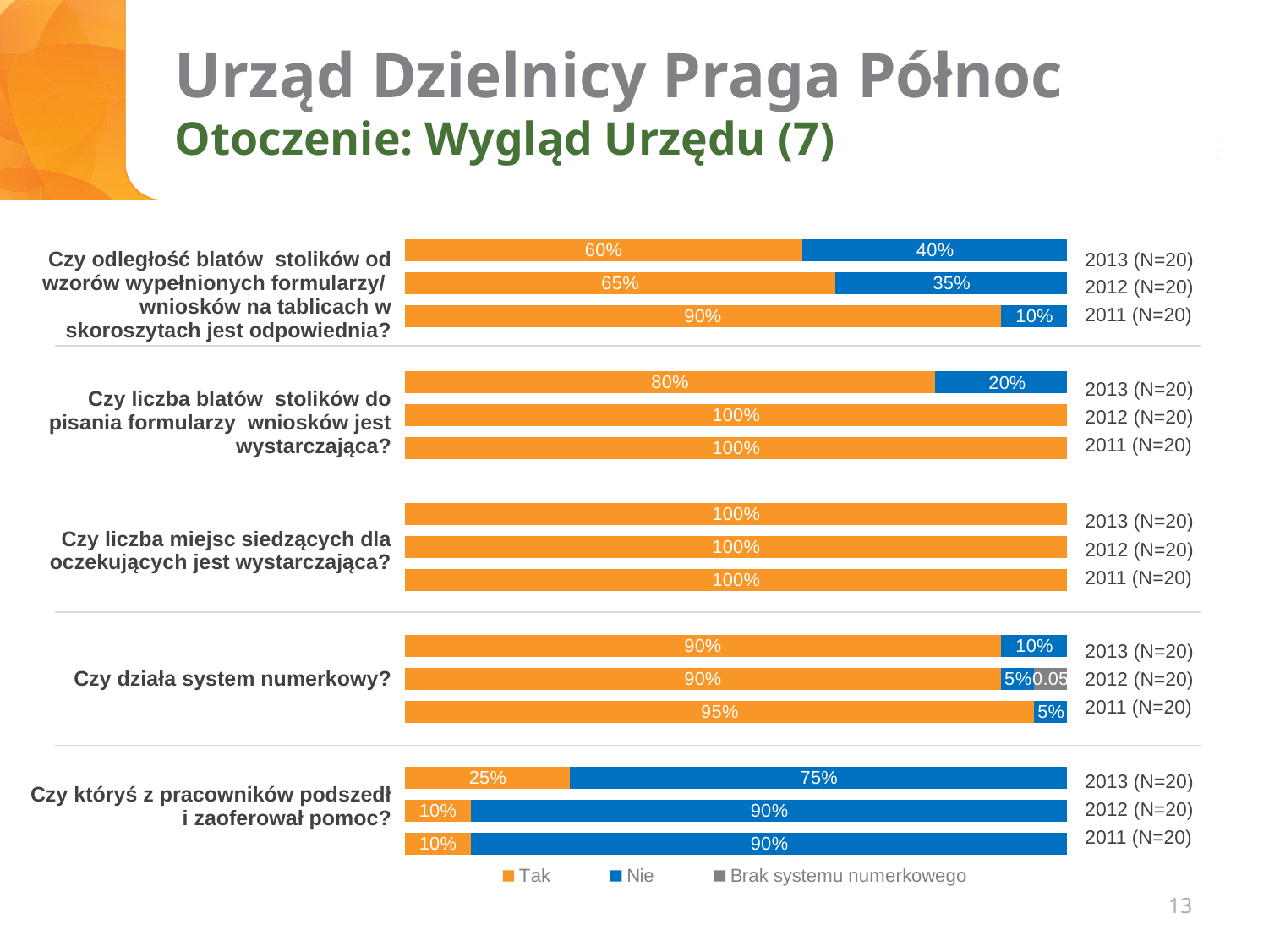
For the question "Czy odległość blatów stolików od wzorów wypełnionych formularzy/wniosków na tablicach w skoroszytach jest odpowiednia?", did the "Tak" share rise or fall from 2011 to 2013? Fall For the question "Czy działa system numerkowy?", what percentage answered "Tak" in 2011? 95% For the question "Czy odległość blatów stolików od wzorów wypełnionych formularzy/wniosków na tablicach w skoroszytach jest odpowiednia?", what percentage answered "Nie" in 2013? 40% What kind of chart is shown on the slide? Stacked bar chart For the question "Czy odległość blatów stolików od wzorów wypełnionych formularzy/wniosków na tablicach w skoroszytach jest odpowiednia?", what is the difference between the "Tak" share in 2011 and in 2013? 30 percentage points In 2013, which had a larger "Tak" share: "Czy liczba blatów stolików do pisania formularzy wniosków jest wystarczająca?" or "Czy odległość blatów stolików od wzorów wypełnionych formularzy/wniosków na tablicach w skoroszytach jest odpowiednia?" Czy liczba blatów stolików do pisania formularzy wniosków jest wystarczająca? For the question "Czy liczba blatów stolików do pisania formularzy wniosków jest wystarczająca?", what percentage answered "Nie" in 2013? 20% How many series does the legend list? 3 What are the three legend entries of the chart? Tak, Nie, Brak systemu numerkowego For the question "Czy któryś z pracowników podszedł i zaoferował pomoc?", what percentage answered "Nie" in 2013? 75% How many years are shown for each question in the chart? 3 What is the total of the 2013 bar for "Czy odległość blatów stolików od wzorów wypełnionych formularzy/wniosków na tablicach w skoroszytach jest odpowiednia?" (Tak plus Nie)? 100%